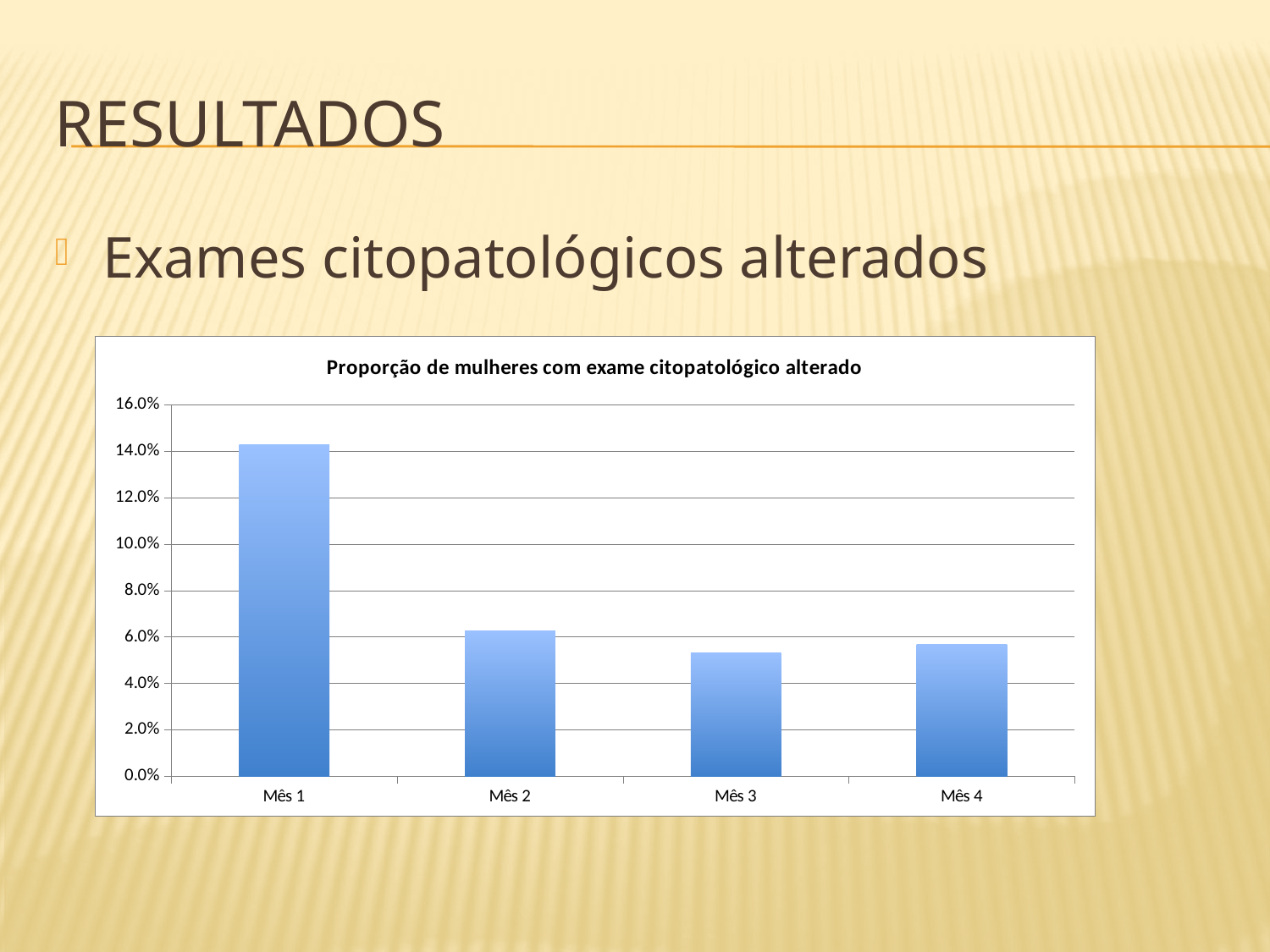
What is the highest value shown on the y axis of the chart? 16.0% Is the value for Mês 2 greater or less than 8.0%? less How many months (categories) are shown on the x axis of the chart? 4 Which is larger, the value for Mês 1 or the value for Mês 2? Mês 1 Which month has the highest proportion of women with altered cytopathological exam? Mês 1 Is the value for Mês 3 greater or less than 6.0%? less What is the title of the chart? Proporção de mulheres com exame citopatológico alterado Which is larger, the value for Mês 2 or the value for Mês 3? Mês 2 Is the value for Mês 4 greater or less than 4.0%? greater What kind of chart is shown on the slide? bar chart From Mês 1 to Mês 3, do the values rise or fall? fall